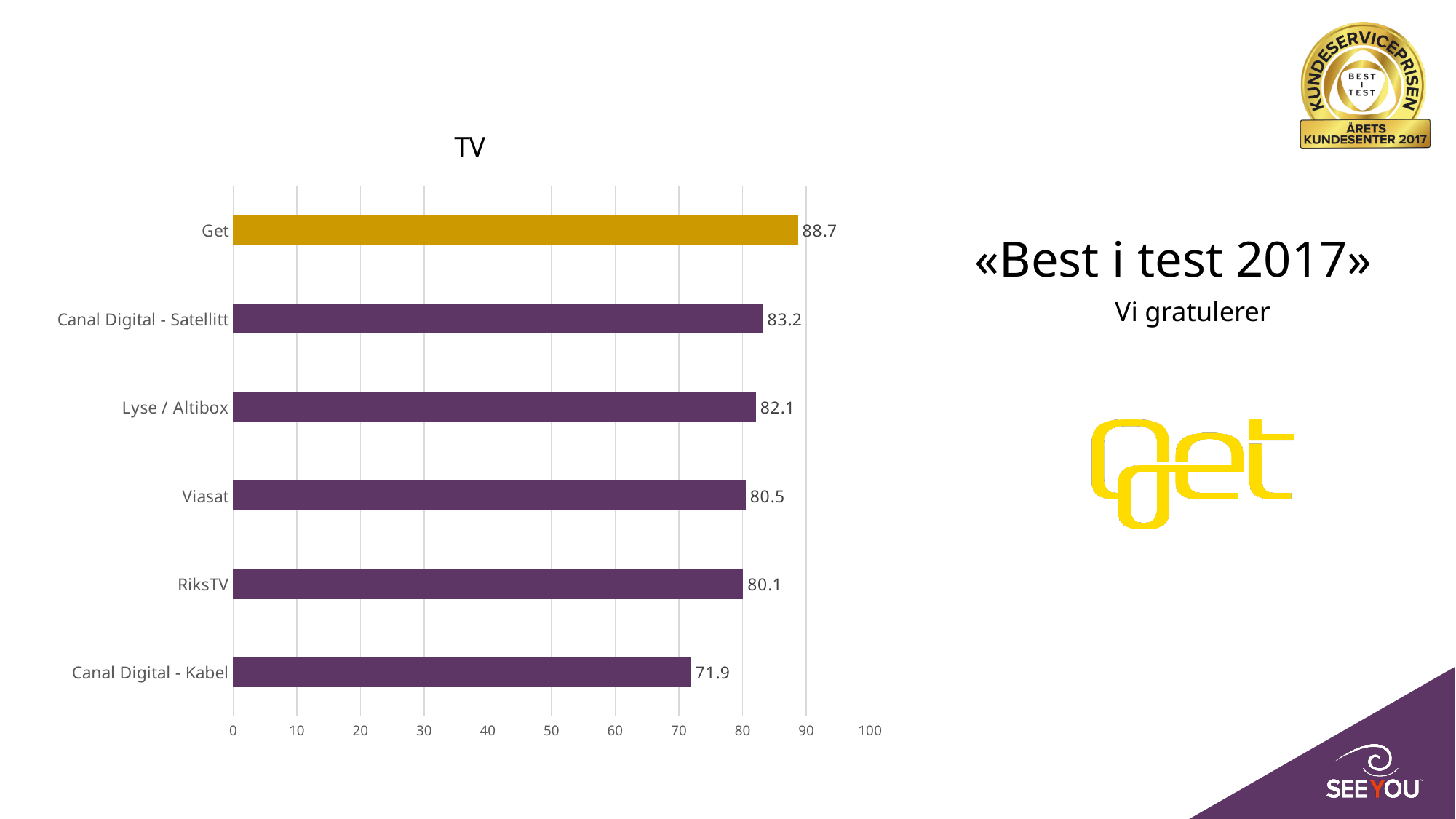
What is the value for Get? 88.7 Which category has the lowest value? Canal Digital - Kabel What is the value for Canal Digital - Kabel? 71.9 What is the title of the chart? TV Which category has the highest value? Get What kind of chart is shown on the slide? Bar chart Which is larger, the value for Lyse / Altibox or the value for Canal Digital - Kabel? Lyse / Altibox How many categories are shown in the chart? 6 What is the value for Canal Digital - Satellitt? 83.2 What is the value for Lyse / Altibox? 82.1 What is the difference between the values for Get and Canal Digital - Satellitt? 5.5 What is the difference between the values for Viasat and RiksTV? 0.4